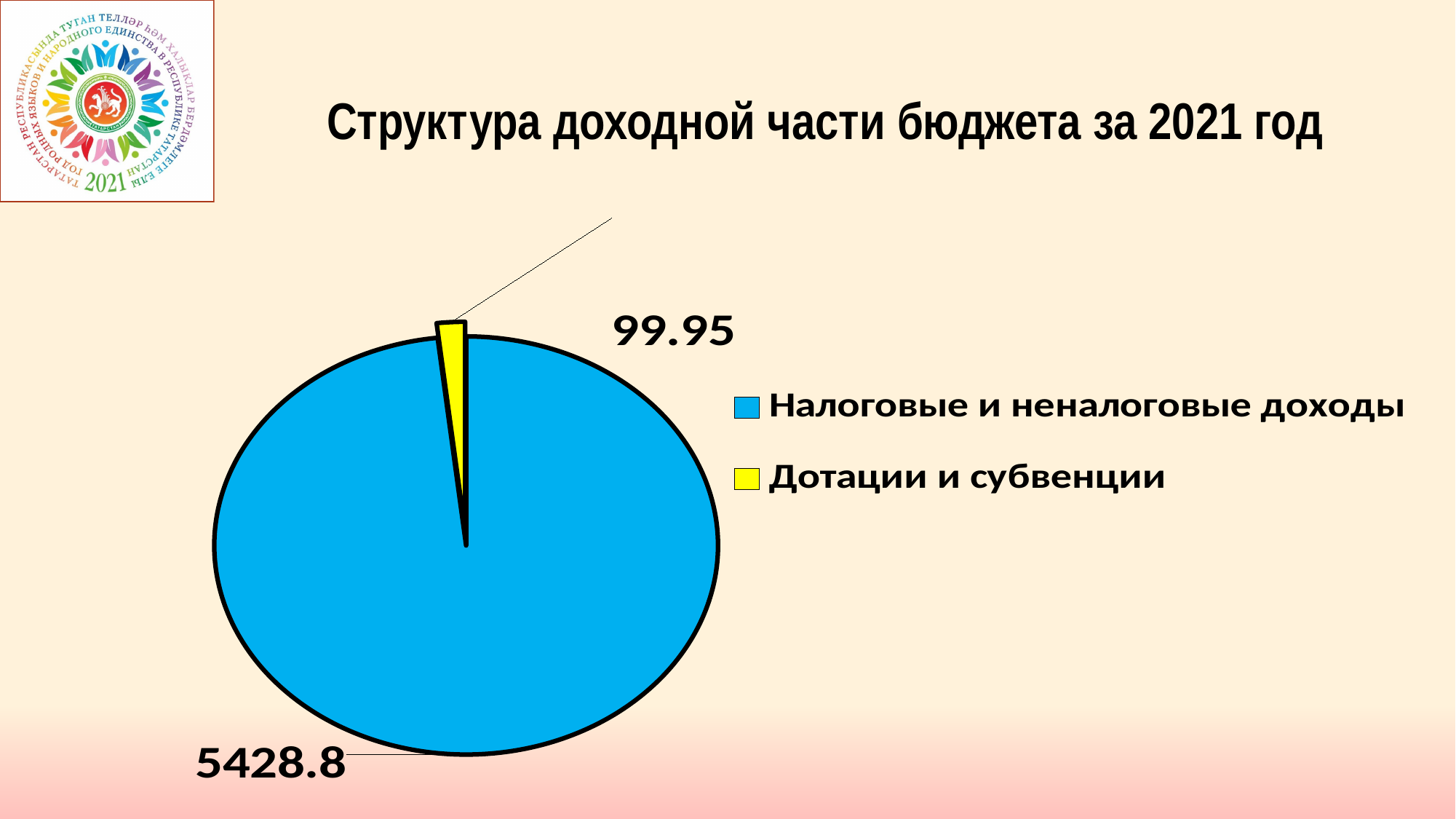
What colour is the slice for Дотации и субвенции? yellow What is the total of the two values shown in the pie chart? 5528.75 What is the difference between the values for Налоговые и неналоговые доходы and Дотации и субвенции? 5328.85 What type of chart is shown on the slide? pie chart Which category has the largest slice of the pie? Налоговые и неналоговые доходы How many categories does the pie chart have? 2 Which is larger: Налоговые и неналоговые доходы or Дотации и субвенции? Налоговые и неналоговые доходы What is the value for Дотации и субвенции? 99.95 How many entries does the legend list? 2 What is the value for Налоговые и неналоговые доходы? 5428.8 What is the title of the chart? Структура доходной части бюджета за 2021 год Which category has the smallest slice of the pie? Дотации и субвенции